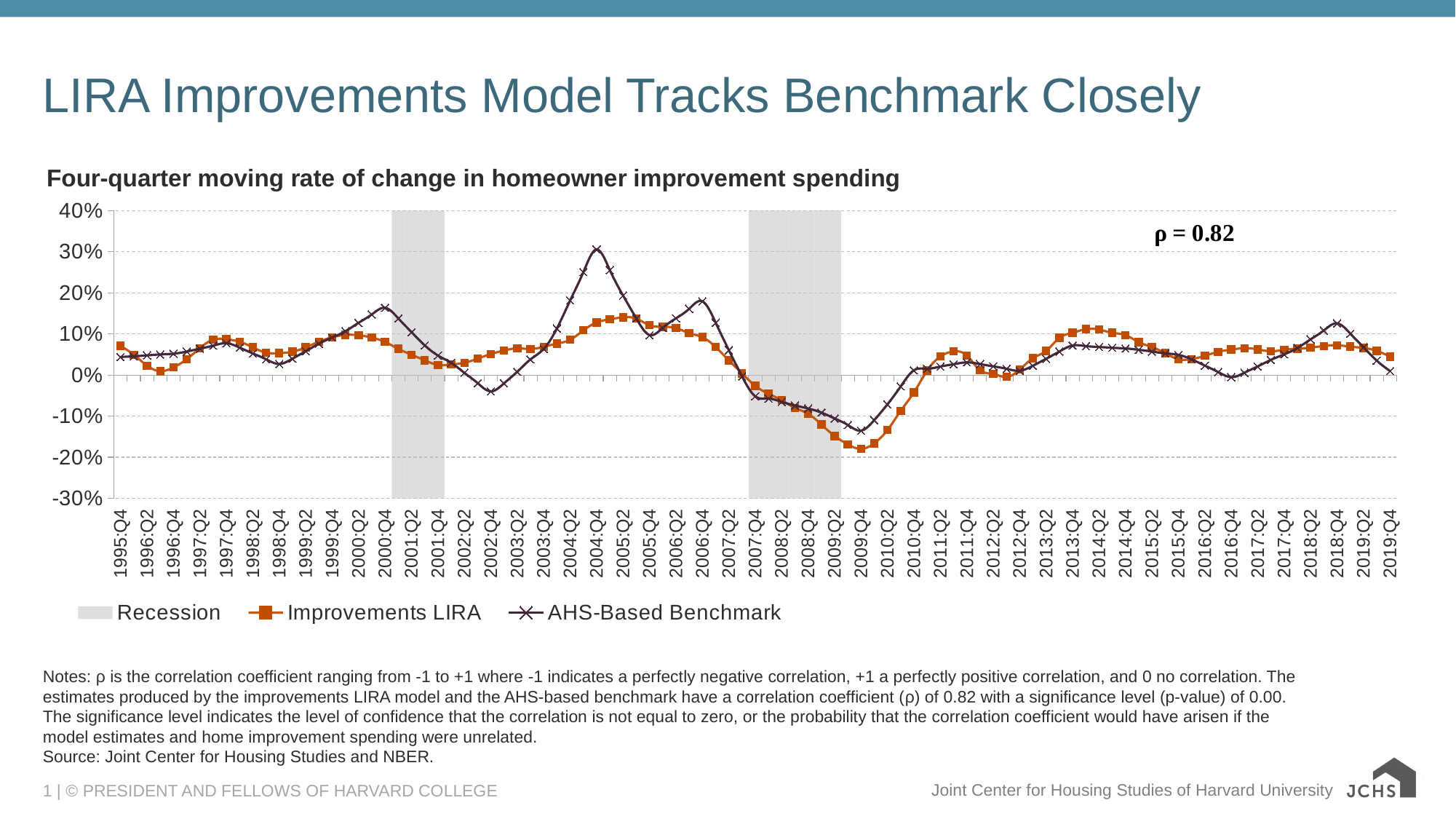
What kind of chart is shown on the slide? line chart Is the AHS-Based Benchmark value at 2004:Q4 greater or less than 20%? greater Is the AHS-Based Benchmark value at 2006:Q4 greater or less than 10%? greater Which series reaches the highest peak on the chart? AHS-Based Benchmark Does the Improvements LIRA series rise or fall between 2007:Q2 and 2009:Q4? fall What is the chart's subtitle describing the plotted measure? Four-quarter moving rate of change in homeowner improvement spending How many entries does the chart legend list? 3 At 2004:Q4, which series has the higher value, Improvements LIRA or AHS-Based Benchmark? AHS-Based Benchmark Is the AHS-Based Benchmark value at 2002:Q4 greater or less than 0%? less What correlation coefficient (ρ) is printed on the chart? ρ = 0.82 At 2009:Q4, which series has the lower value, Improvements LIRA or AHS-Based Benchmark? Improvements LIRA